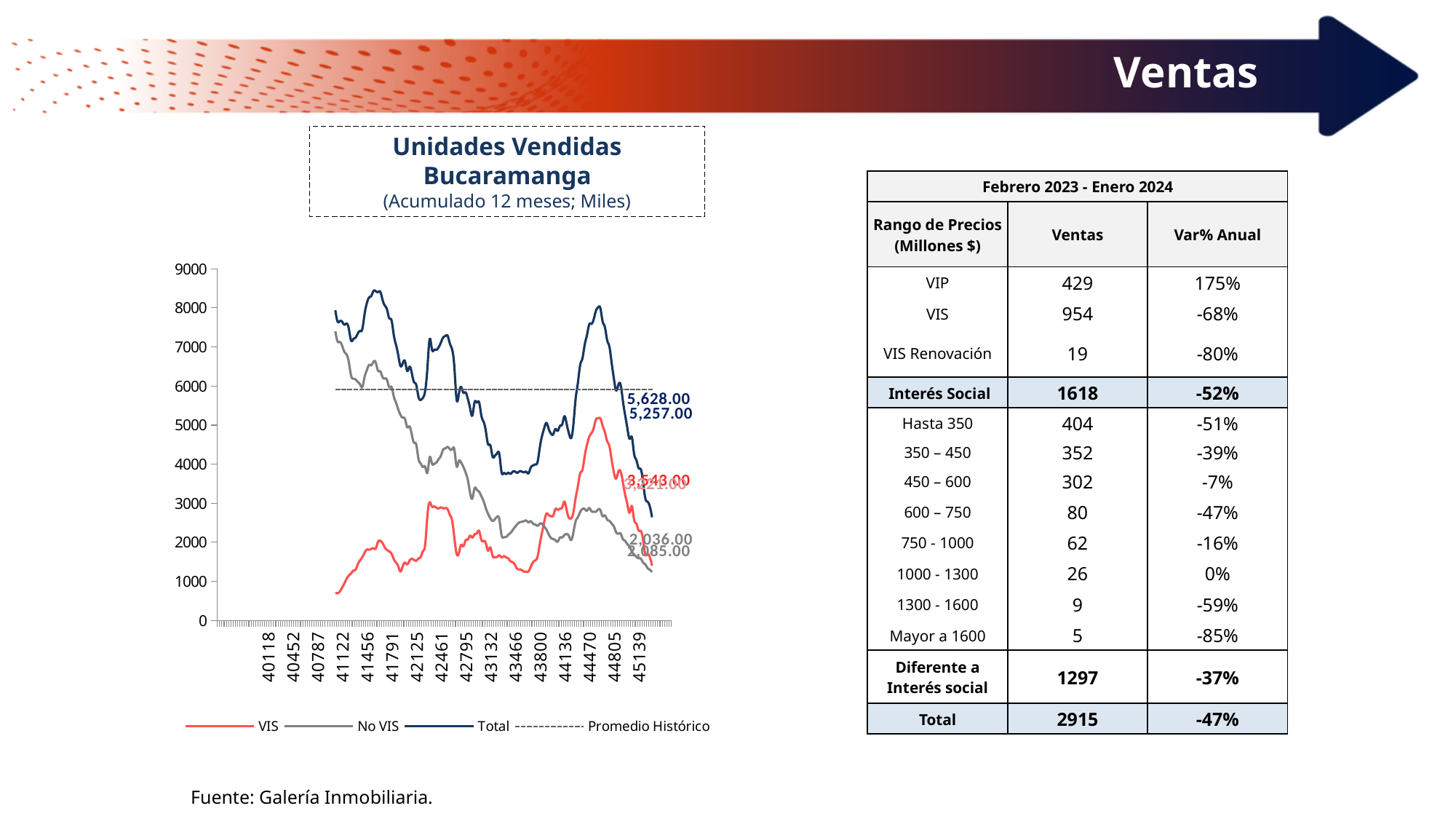
In the 'Unidades Vendidas Bucaramanga' chart, is the lowest point of the Total line (around 43466) greater or less than 4000? less Which series in the 'Unidades Vendidas Bucaramanga' chart starts at the lowest value on the left? VIS Overall, does the Total line in the 'Unidades Vendidas Bucaramanga' chart rise or fall from its start to its end? fall In the 'Unidades Vendidas Bucaramanga' chart, is the first value of the VIS line greater or less than 1000? less In the 'Unidades Vendidas Bucaramanga' chart, is the highest peak of the Total line greater or less than 8000? greater Which series in the 'Unidades Vendidas Bucaramanga' chart is drawn as a dashed line? Promedio Histórico What type of chart is shown under the title 'Unidades Vendidas Bucaramanga'? line chart Which series in the 'Unidades Vendidas Bucaramanga' chart has the highest values across the whole period? Total What colour is the 'Total' line in the 'Unidades Vendidas Bucaramanga' chart? navy blue How many series does the legend of the 'Unidades Vendidas Bucaramanga' chart list? 4 At the right end of the 'Unidades Vendidas Bucaramanga' chart, which is higher: the Total line or the VIS line? Total